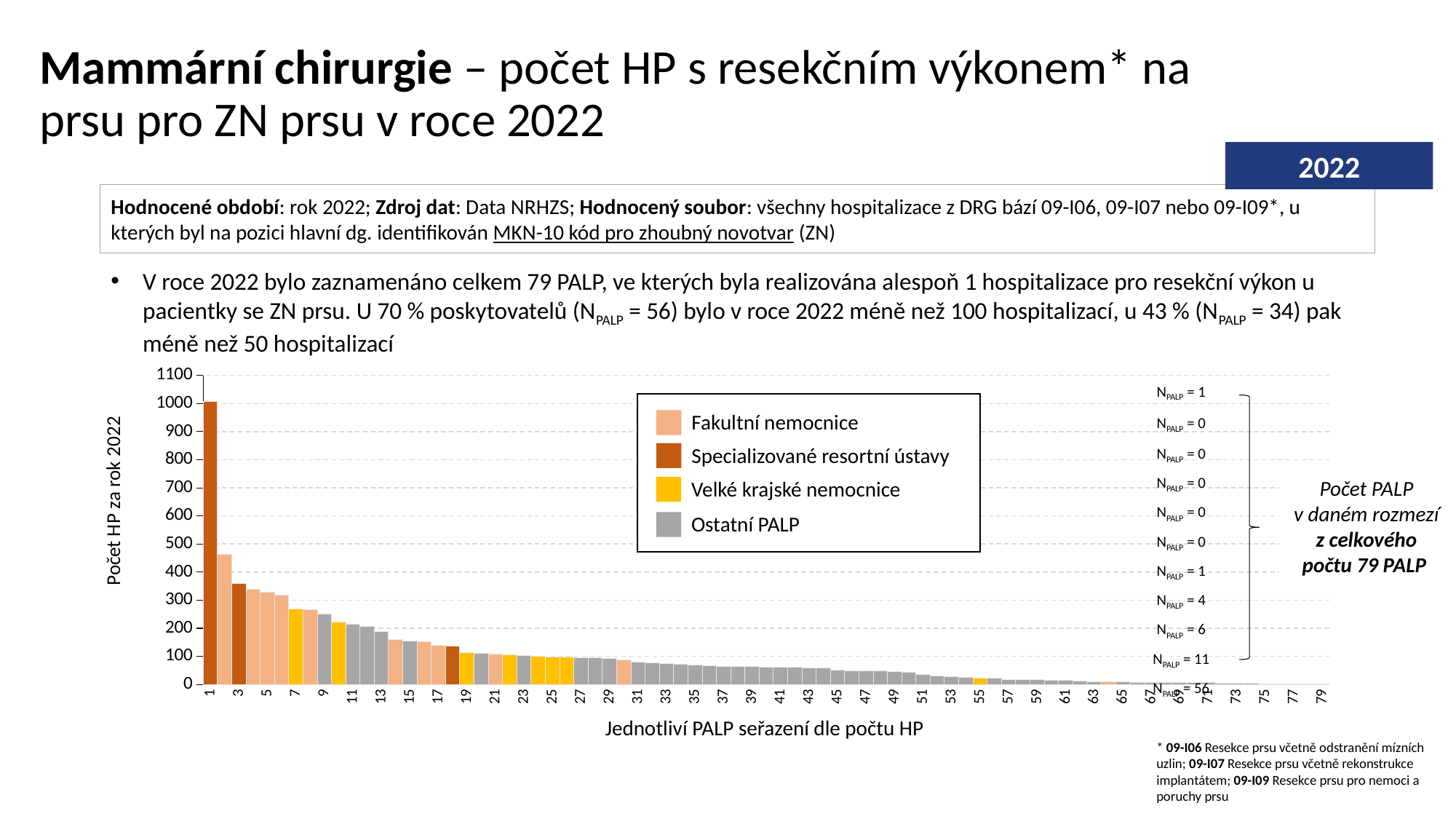
What is the label of the y axis of the chart? Počet HP za rok 2022 Is the value for PALP 10 greater or less than 300? less How many entries does the chart legend list? 4 What kind of chart is shown on the slide? bar chart Do the bar values rise or fall from left to right along the x axis? fall Which PALP (x-axis position) has the highest number of HP in the chart? 1 Is the value for PALP 40 greater or less than 100? less What colour represents 'Velké krajské nemocnice' in the chart legend? yellow How many PALP (bars) are plotted along the x axis of the chart? 79 Is the value for PALP 2 greater or less than 400? greater Which has a larger value, PALP 1 or PALP 2? PALP 1